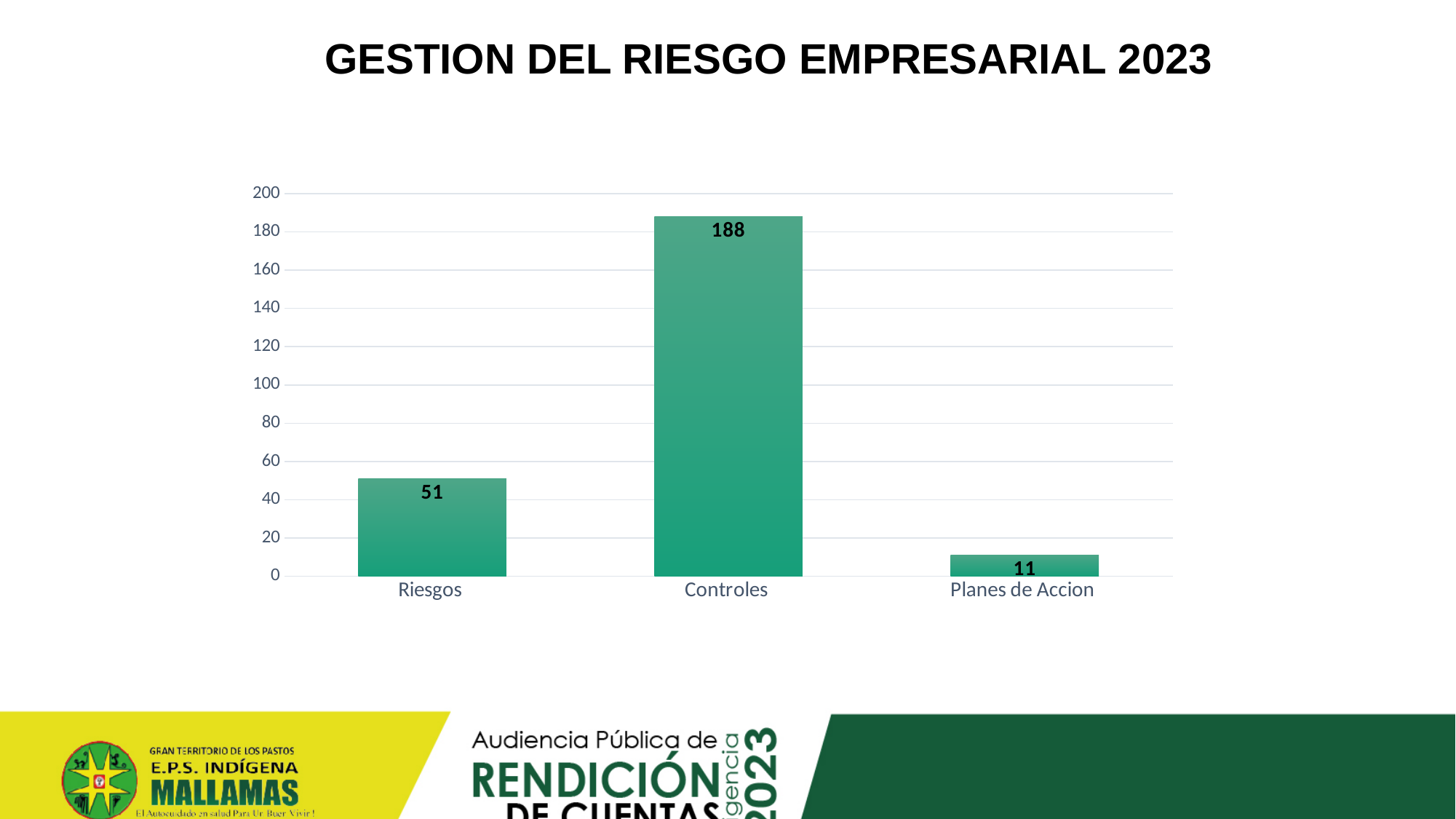
What kind of chart is shown on the slide? Bar chart What is the difference between the values for Controles and Riesgos? 137 What is the difference between the values for Riesgos and Planes de Accion? 40 Which is larger, the value for Riesgos or the value for Planes de Accion? Riesgos Which category has the highest value? Controles Which category has the lowest value? Planes de Accion What is the value for Planes de Accion? 11 What is the value for Controles? 188 What is the value for Riesgos? 51 Is the value for Controles greater or less than 160? greater How many categories are shown on the x axis? 3 What is the title of the slide? GESTION DEL RIESGO EMPRESARIAL 2023